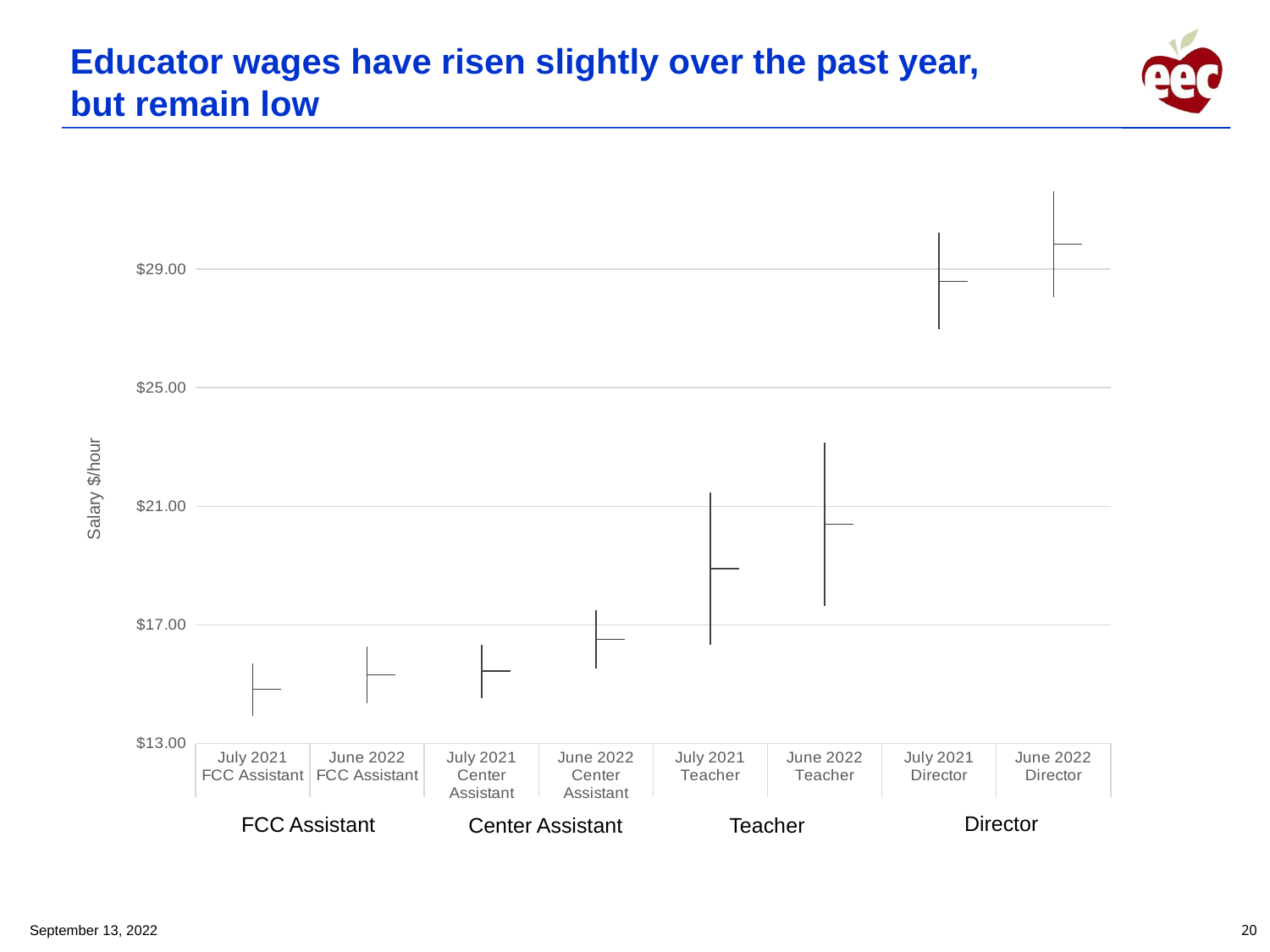
Do the salary values generally rise or fall moving from FCC Assistant to Director along the x axis? rise Which is larger, the salary value for June 2022 Teacher or July 2021 Teacher? June 2022 Teacher Is the salary value for July 2021 Director greater or less than $25.00? greater Which category has the highest salary value in the chart? June 2022 Director Is the salary value for June 2022 Teacher greater or less than $21.00? less How many categories are shown along the x axis of the chart? 8 What is the title of the slide's chart? Educator wages have risen slightly over the past year, but remain low What is the label on the y axis of the chart? Salary $/hour Is the salary value for June 2022 Director greater or less than $29.00? greater What kind of chart is shown on the slide? Stock (high-low) chart Which category has the lowest salary value in the chart? July 2021 FCC Assistant